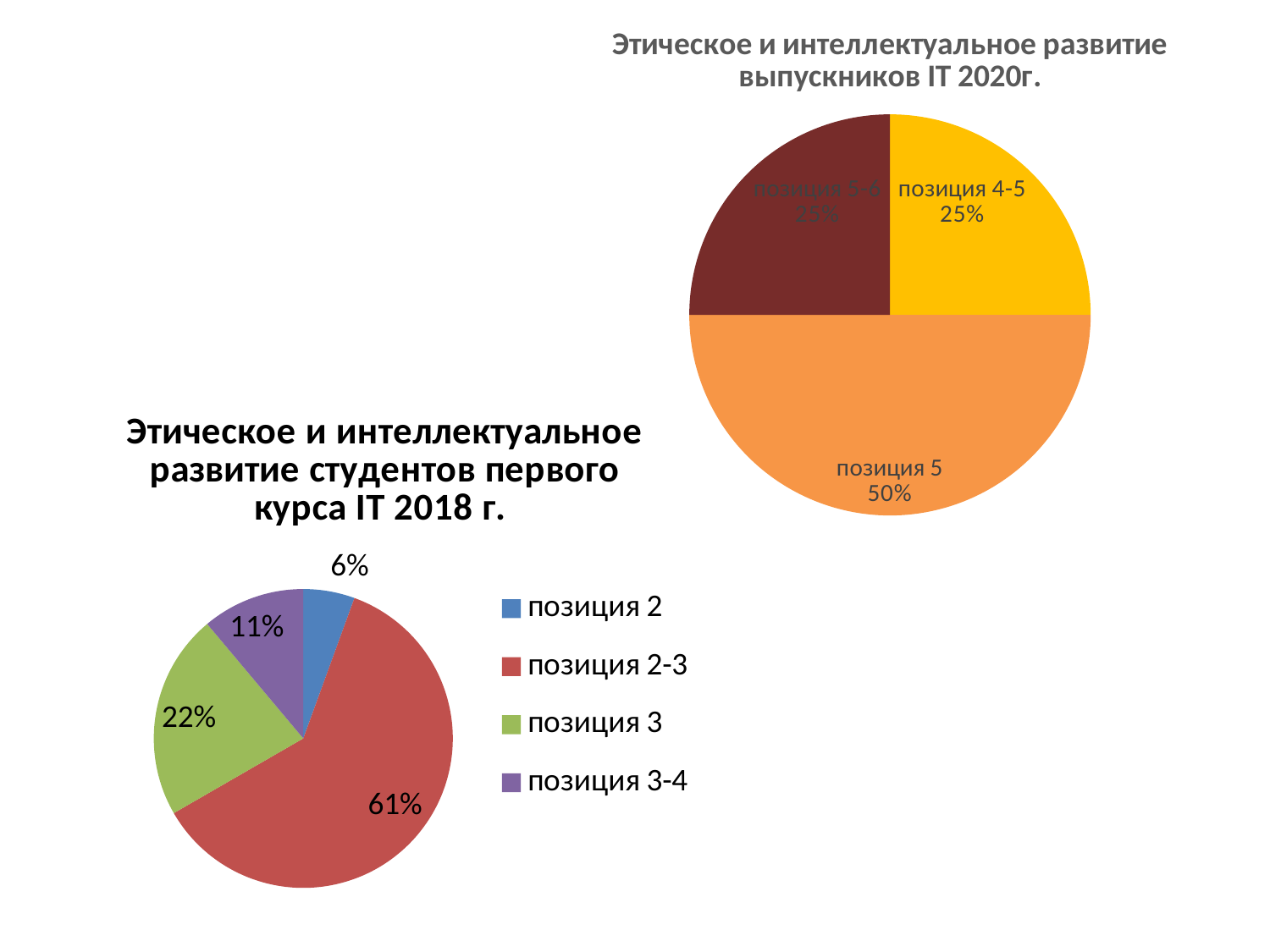
What type of chart is the chart titled "Этическое и интеллектуальное развитие выпускников IT 2020г."? pie chart In the chart titled "Этическое и интеллектуальное развитие студентов первого курса IT 2018 г.", which category has the smallest slice? позиция 2 In the chart titled "Этическое и интеллектуальное развитие студентов первого курса IT 2018 г.", what is the difference between the shares of позиция 3 and позиция 3-4? 11% In the chart titled "Этическое и интеллектуальное развитие выпускников IT 2020г.", what share does позиция 5 have? 50% In the chart titled "Этическое и интеллектуальное развитие студентов первого курса IT 2018 г.", which category has the largest slice? позиция 2-3 In the chart titled "Этическое и интеллектуальное развитие выпускников IT 2020г.", what share does позиция 4-5 have? 25% In the chart titled "Этическое и интеллектуальное развитие студентов первого курса IT 2018 г.", what share does позиция 2 have? 6% In the chart titled "Этическое и интеллектуальное развитие студентов первого курса IT 2018 г.", what share does позиция 2-3 have? 61% In the chart titled "Этическое и интеллектуальное развитие студентов первого курса IT 2018 г.", what share does позиция 3 have? 22% In the chart titled "Этическое и интеллектуальное развитие выпускников IT 2020г.", which category has the largest slice? позиция 5 In the chart titled "Этическое и интеллектуальное развитие выпускников IT 2020г.", how many slices does the pie have? 3 In the chart titled "Этическое и интеллектуальное развитие студентов первого курса IT 2018 г.", how many categories does the legend list? 4